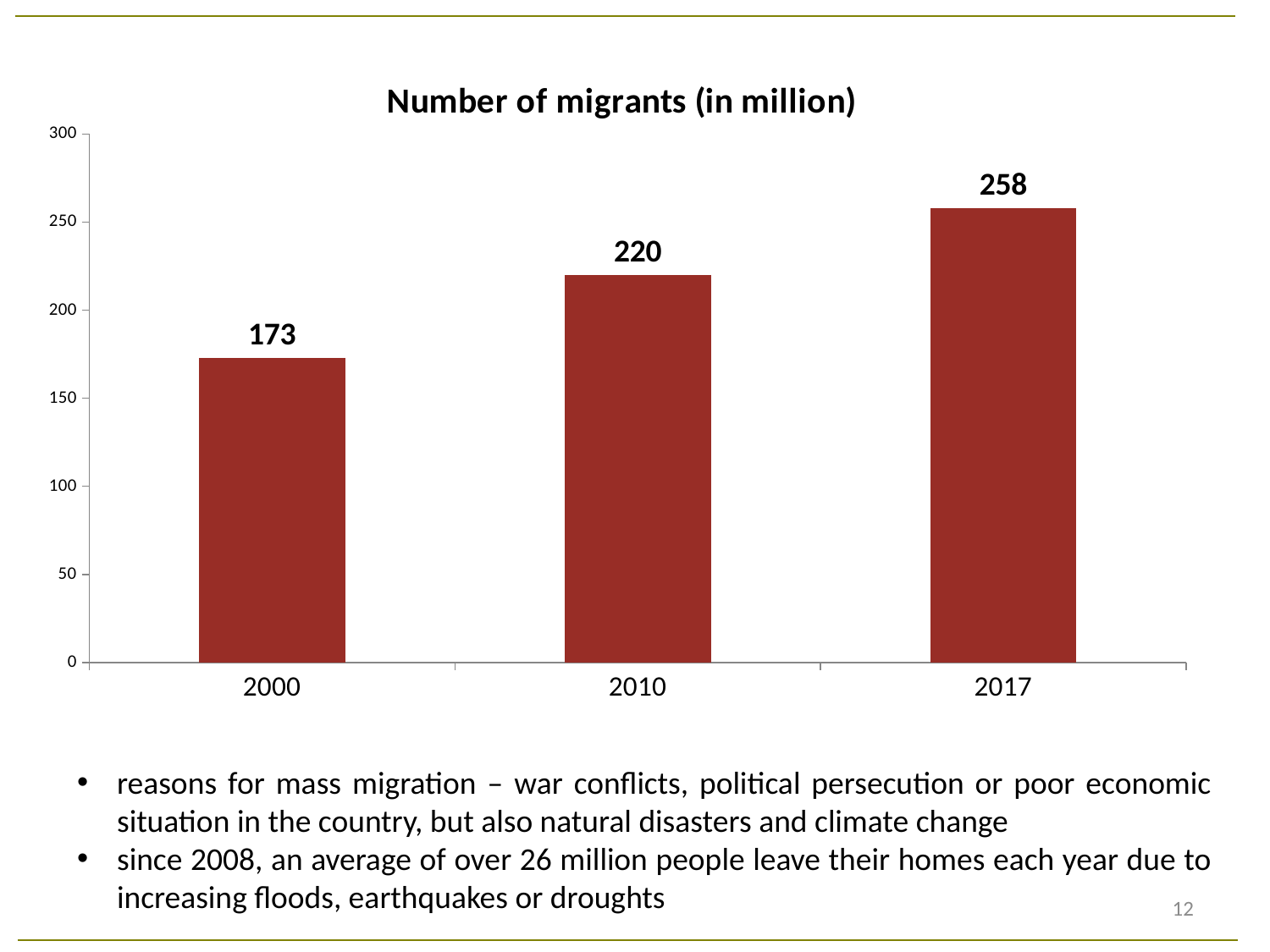
How many years are shown on the chart? 3 What is the number of migrants (in million) for 2017? 258 Is the value for 2010 greater or less than 200? greater What is the difference in the number of migrants (in million) between 2010 and 2000? 47 Which year has the highest number of migrants? 2017 What is the number of migrants (in million) for 2010? 220 What is the difference in the number of migrants (in million) between 2017 and 2000? 85 Does the number of migrants rise or fall from 2000 to 2017? Rise What is the number of migrants (in million) for 2000? 173 Which year has more migrants, 2010 or 2017? 2017 What kind of chart is shown on the slide? Bar chart Which year has the lowest number of migrants? 2000